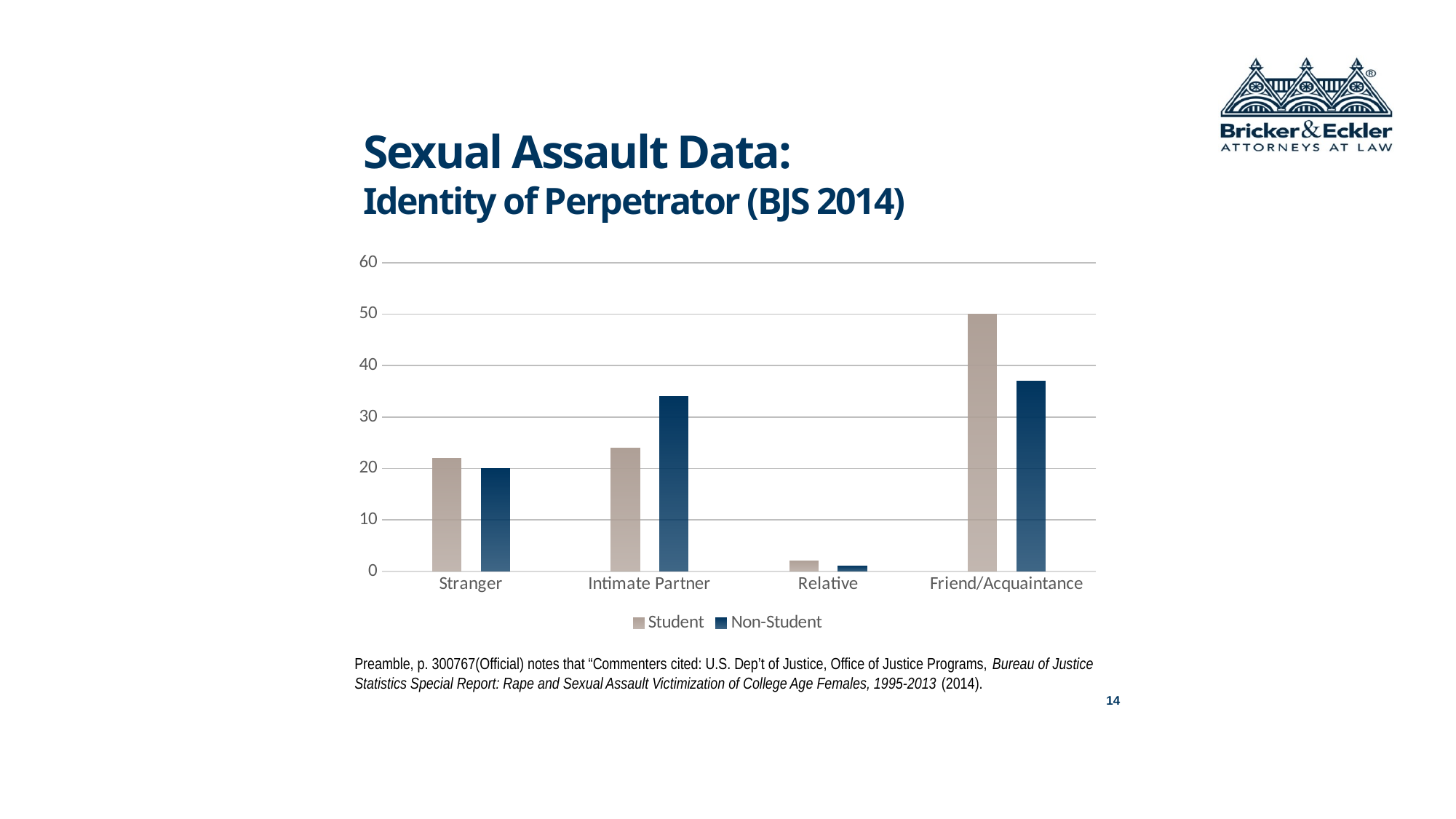
Which category has the lowest Non-Student value? Relative In the Intimate Partner category, which is larger, the Student or the Non-Student value? Non-Student What are the two series named in the legend? Student and Non-Student Is the Non-Student value for Intimate Partner greater or less than 30? greater What is the value for Non-Student in the Stranger category? 20 How many series does the legend list? 2 What kind of chart is shown on the slide? Bar chart In the Friend/Acquaintance category, which is larger, the Student or the Non-Student value? Student What is the value for Student in the Friend/Acquaintance category? 50 Which category has the highest Student value? Friend/Acquaintance Is the Non-Student value for Friend/Acquaintance greater or less than 40? less How many perpetrator categories are shown on the x axis? 4